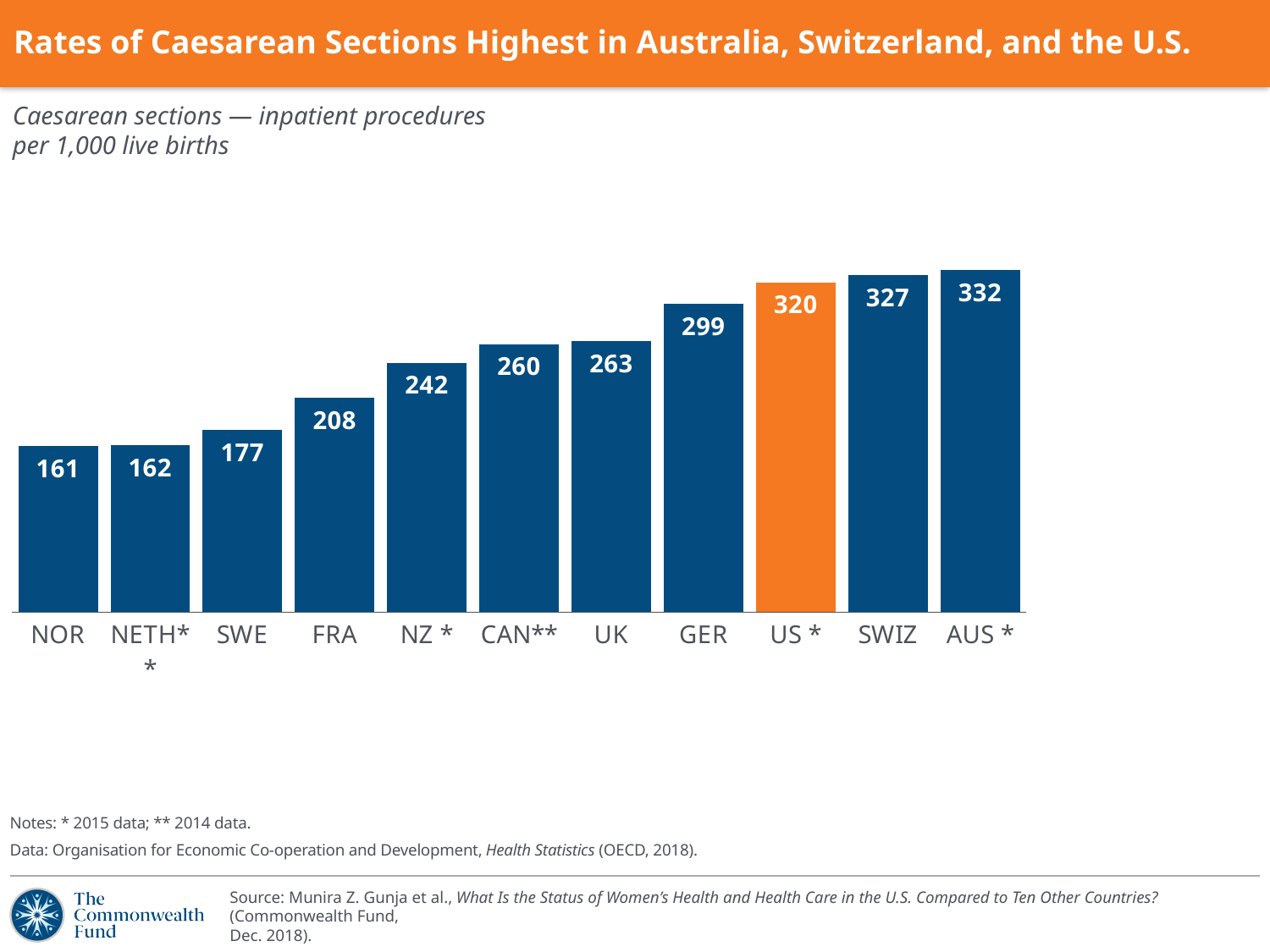
What is the value for Germany (GER)? 299 Which bar is coloured orange instead of blue? US What is the value for France (FRA)? 208 Which country has the lowest rate of caesarean sections? NOR What is the difference between the values for SWIZ and the US? 7 What is the value for the US? 320 How many countries are shown in the chart? 11 Do the values rise or fall from left to right along the x axis? Rise Which country has the highest rate of caesarean sections? AUS Which is larger, the value for CAN or the value for UK? UK What kind of chart is shown on the slide? Bar chart What is the difference between the values for AUS and NOR? 171